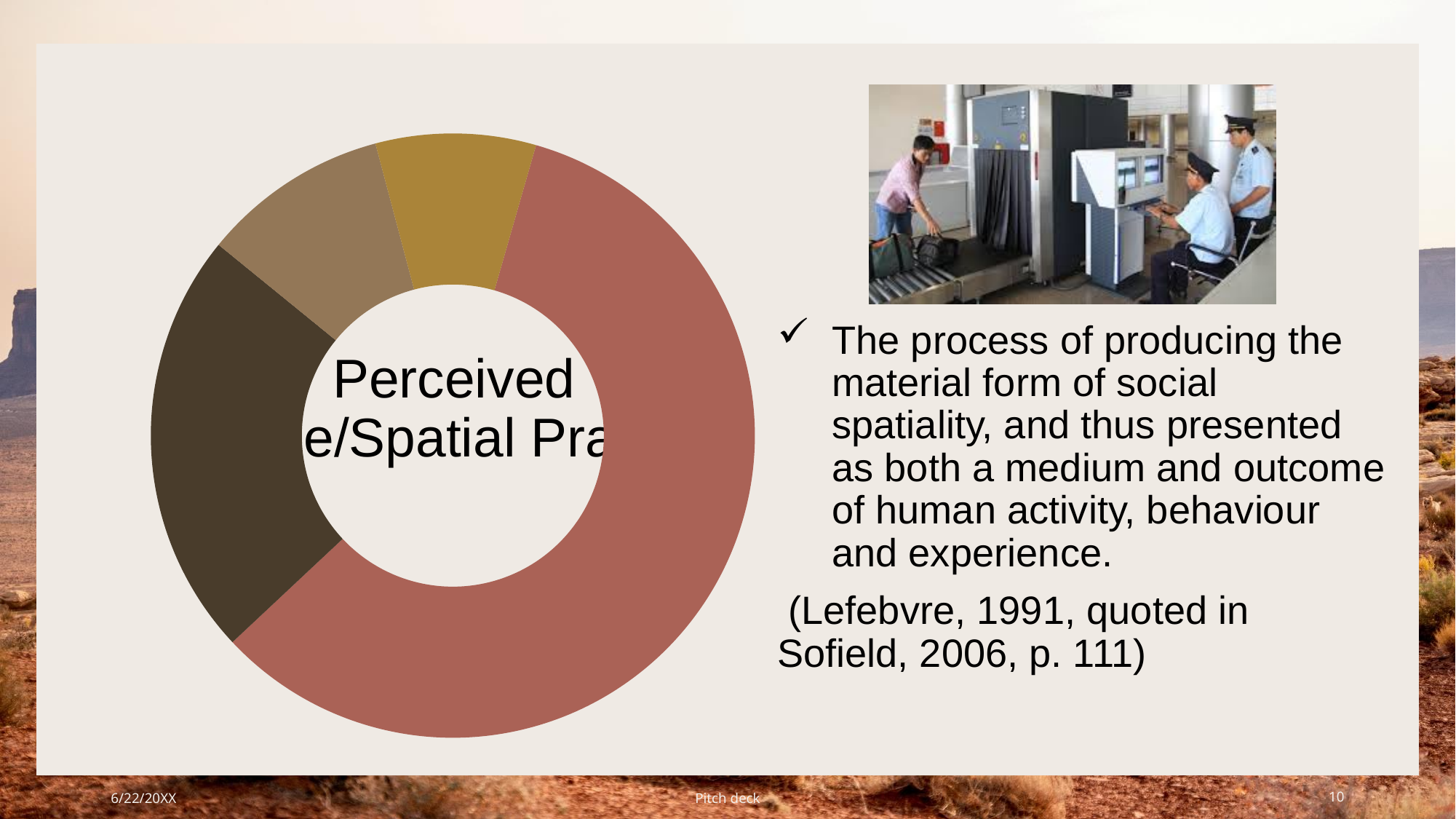
Which colour slice is the largest in the doughnut chart? The reddish-brown slice What kind of chart is shown on the left of the slide? Doughnut chart How many slices does the doughnut chart have? 4 Is the gold slice larger or smaller than the tan slice? Smaller Does the doughnut chart display a legend? No Is the reddish-brown slice larger or smaller than the dark brown slice? Larger Does the doughnut chart show data labels with values on its slices? No Which colour slice is the smallest in the doughnut chart? The gold slice